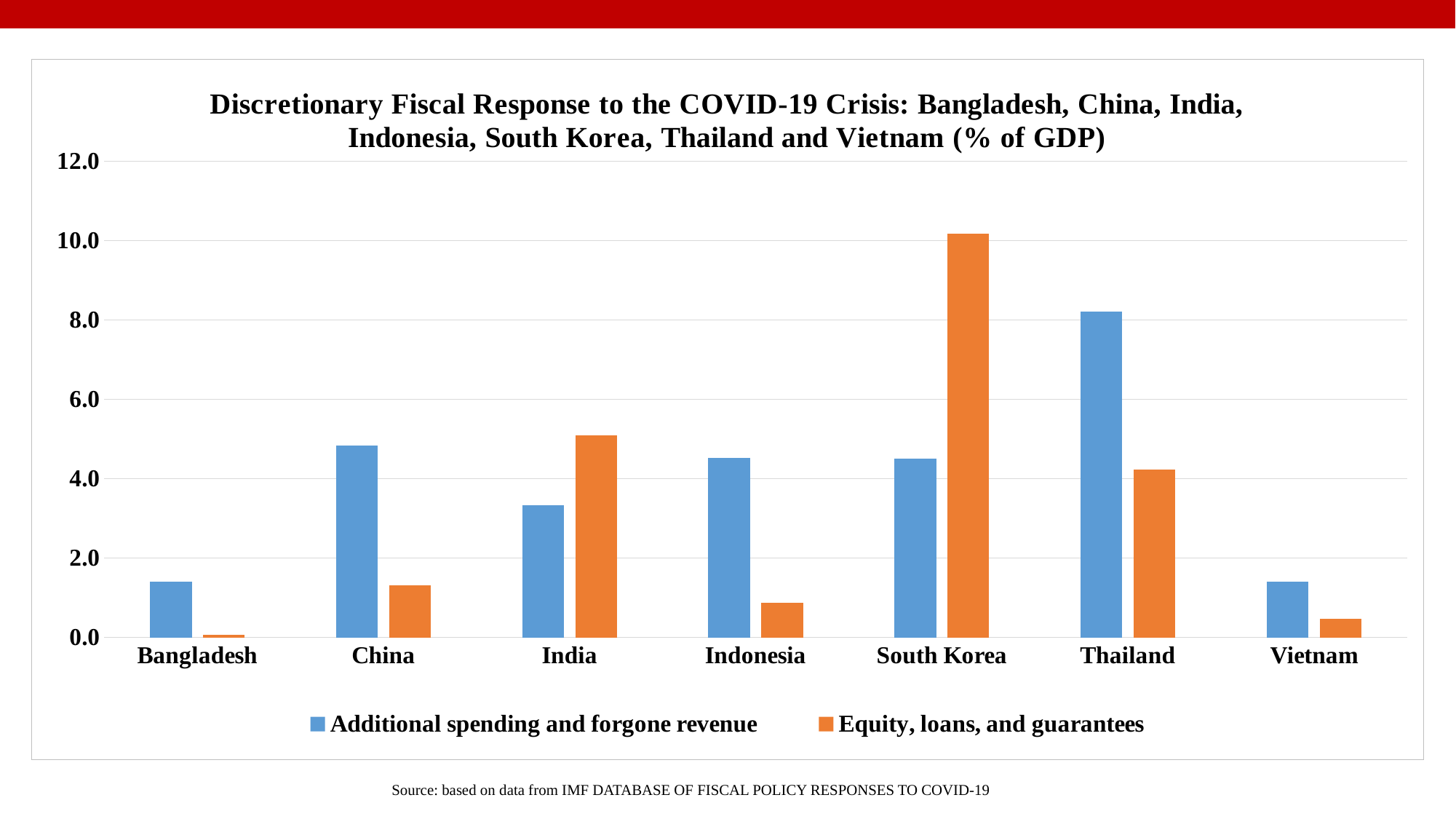
How many countries are shown on the x axis of the chart? 7 Is the value for Additional spending and forgone revenue in Thailand greater or less than 8.0? greater Is the value for Additional spending and forgone revenue in India greater or less than 4.0? less For India, which is larger: Additional spending and forgone revenue or Equity, loans, and guarantees? Equity, loans, and guarantees For Thailand, which is larger: Additional spending and forgone revenue or Equity, loans, and guarantees? Additional spending and forgone revenue Which country has the lowest value for Equity, loans, and guarantees? Bangladesh Is the value for Equity, loans, and guarantees in South Korea greater or less than 10.0? greater Which colour represents Equity, loans, and guarantees in the chart? orange What kind of chart is shown on the slide? bar chart Which country has the highest value for Equity, loans, and guarantees? South Korea Which country has the highest value for Additional spending and forgone revenue? Thailand How many series does the legend list? 2